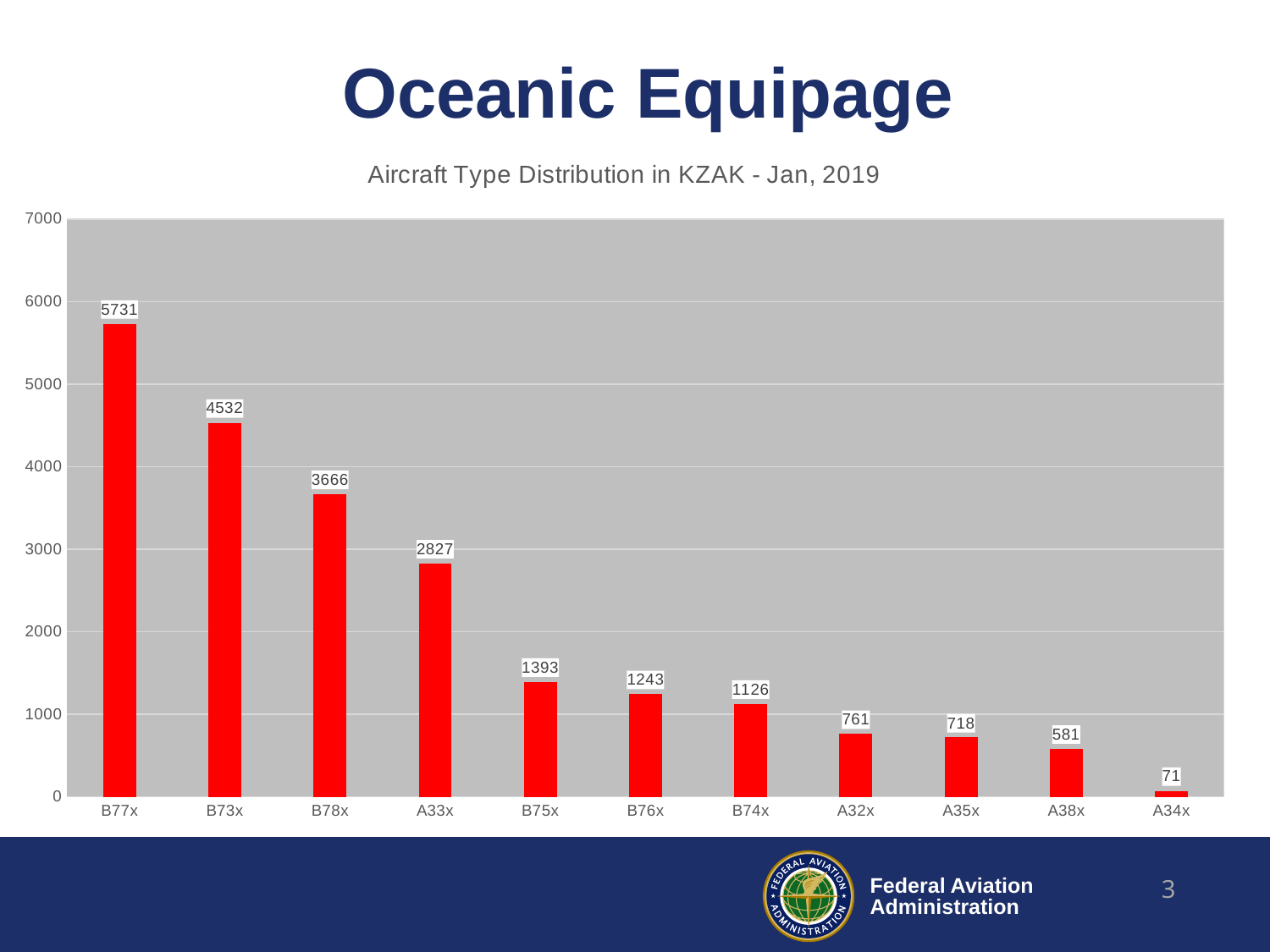
What is the value for A33x? 2827 How many aircraft types are shown on the x axis? 11 Do the values rise or fall from left to right along the x axis? fall Which aircraft type has the highest value? B77x What is the value for B77x? 5731 Is the value for B74x greater or less than 1000? greater What is the value for A35x? 718 What is the difference between the values for B73x and B78x? 866 What kind of chart is shown? bar chart Which has a larger value, B75x or B76x? B75x What is the title of the chart? Aircraft Type Distribution in KZAK - Jan, 2019 Which aircraft type has the lowest value? A34x